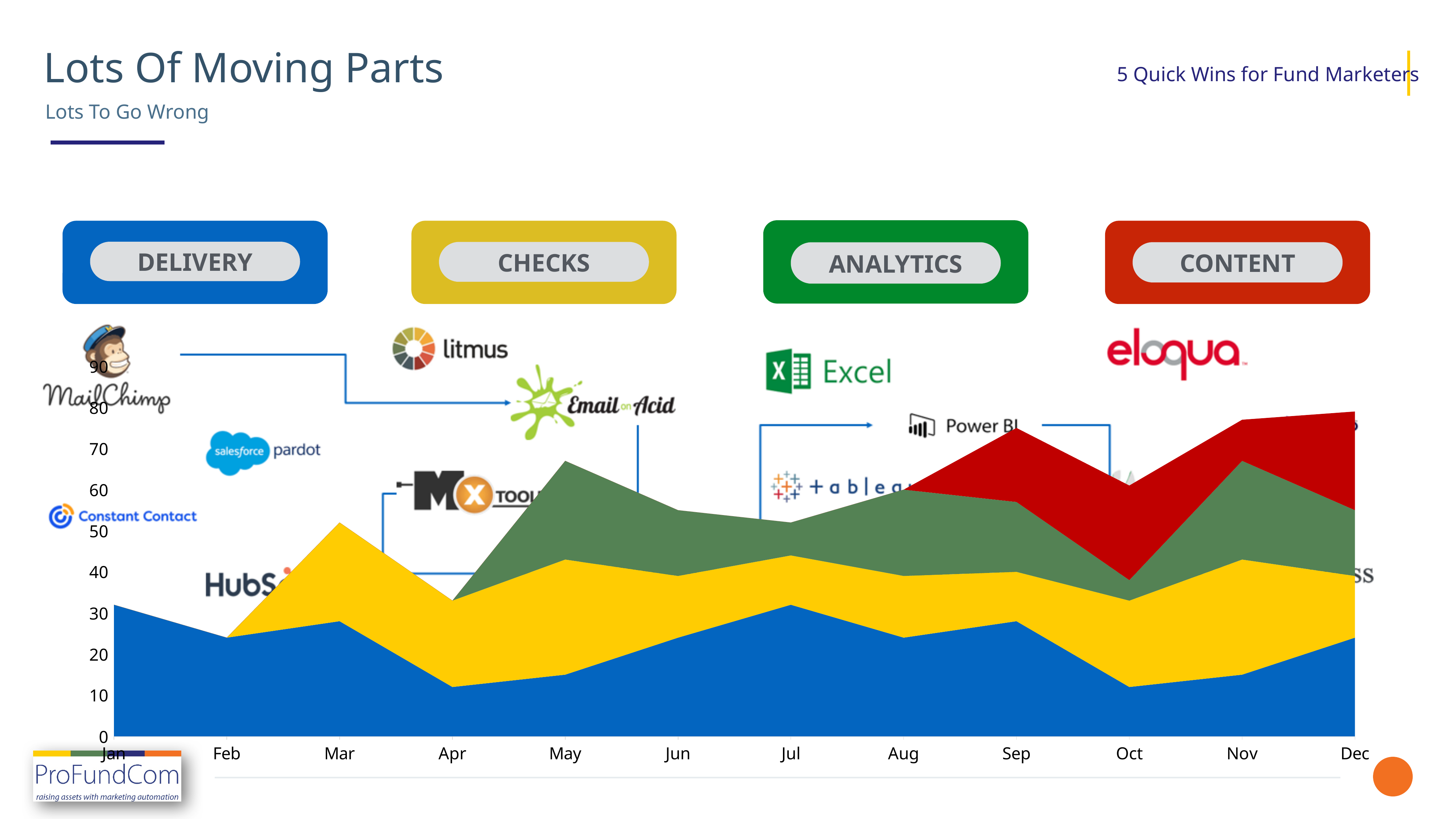
Is the value of the blue (bottom) area for Oct greater or less than 20? less Is the value of the blue (bottom) area for Jul greater or less than 20? greater How many coloured areas are stacked in the chart? 4 Does the blue (bottom) area rise or fall from Jan to Apr? fall Which is larger for the blue (bottom) area: Jan or Apr? Jan Is the top of the stacked areas for Dec greater or less than 70? greater What is the first month label on the x axis of the chart? Jan Does the top of the stacked areas rise or fall from Oct to Dec? rise How many months are shown along the x axis of the chart? 12 What kind of chart is shown on the slide? area chart